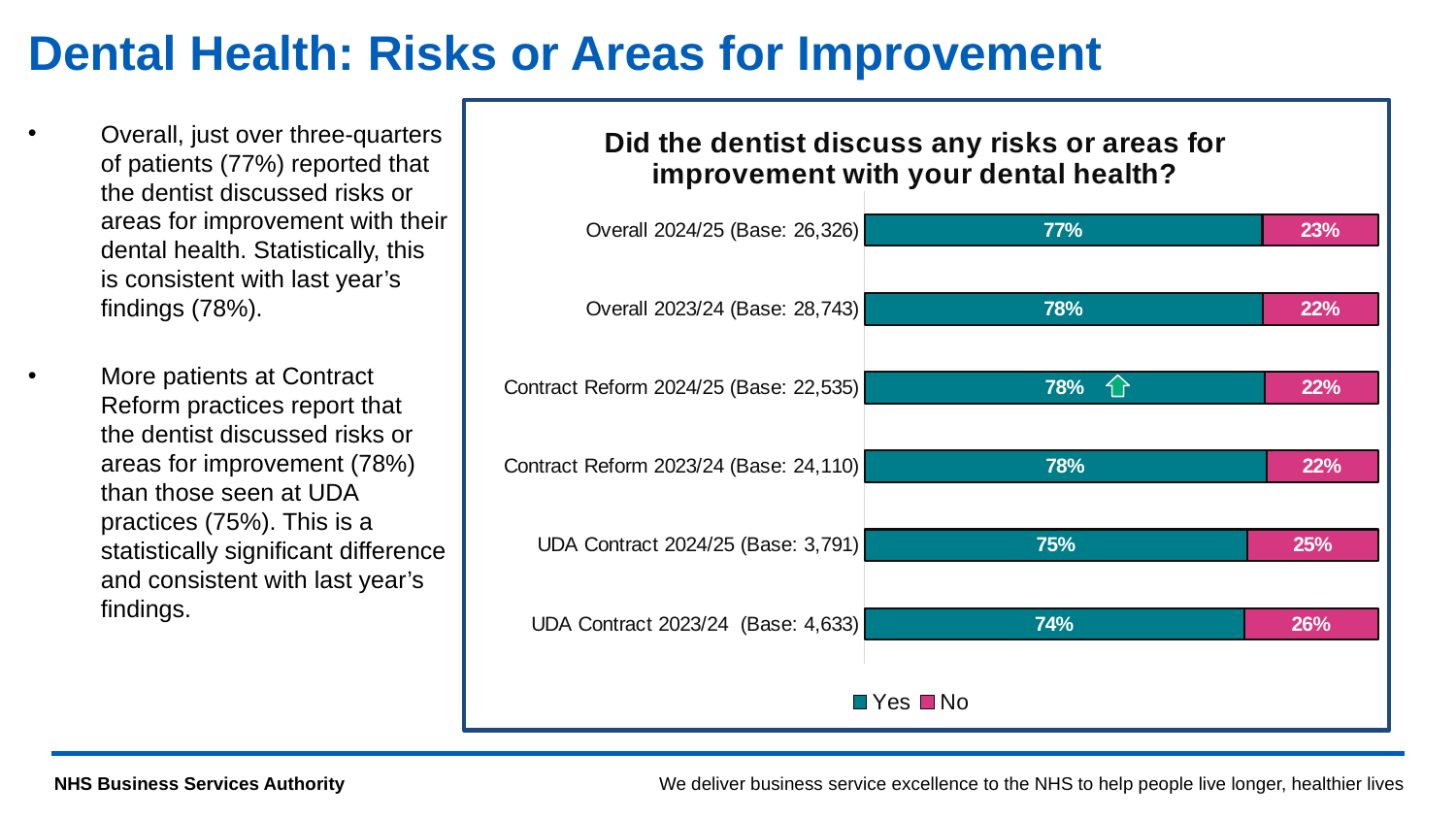
What is the total of the Yes and No values for Overall 2024/25? 100% What is the No value for UDA Contract 2024/25? 25% What is the difference between the Yes values for Contract Reform 2024/25 and UDA Contract 2024/25? 3% What is the Yes value for Contract Reform 2024/25? 78% Which category has the lowest Yes percentage? UDA Contract 2023/24 What kind of chart is shown on the slide? Stacked bar chart Which is larger, the Yes value for Overall 2023/24 or the Yes value for UDA Contract 2024/25? Overall 2023/24 Which category has the highest No percentage? UDA Contract 2023/24 What percentage of patients answered Yes for Overall 2024/25? 77% How many categories are shown in the chart? 6 How many series does the legend list? 2 What percentage of patients answered No for UDA Contract 2023/24? 26%